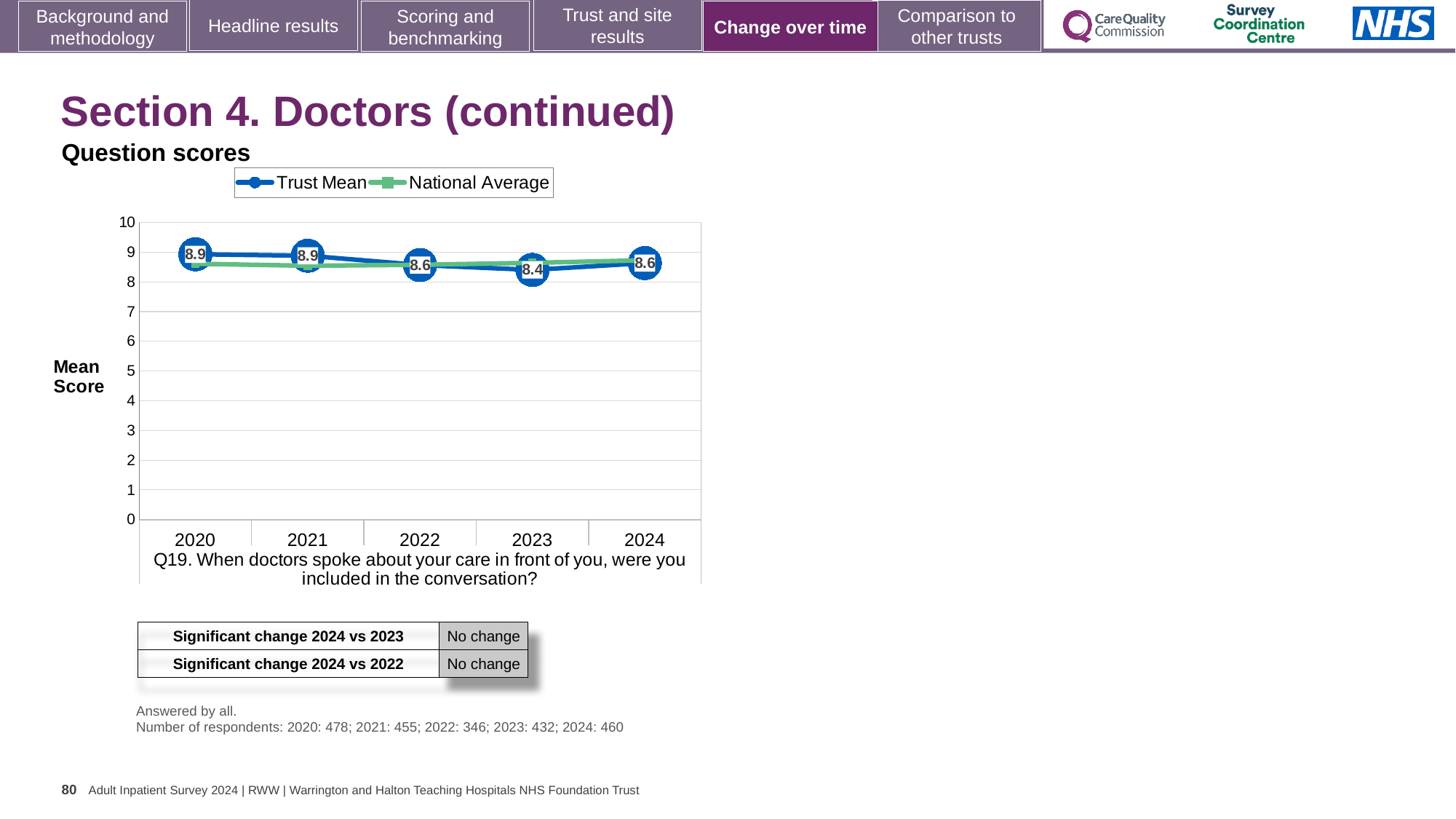
What is the Trust Mean score for 2024? 8.6 What kind of chart is shown on the slide? Line chart Which is larger, the Trust Mean score for 2021 or for 2023? 2021 What is the Trust Mean score for 2023? 8.4 Does the Trust Mean score rise or fall from 2020 to 2023? Fall How many series does the legend list? 2 What is the difference between the Trust Mean score in 2020 and in 2023? 0.5 In which year is the Trust Mean score lowest? 2023 What is the Trust Mean score for 2020? 8.9 What is the label on the y axis of the chart? Mean Score Is the National Average value for 2024 greater or less than 8? greater How many years are plotted on the x axis? 5